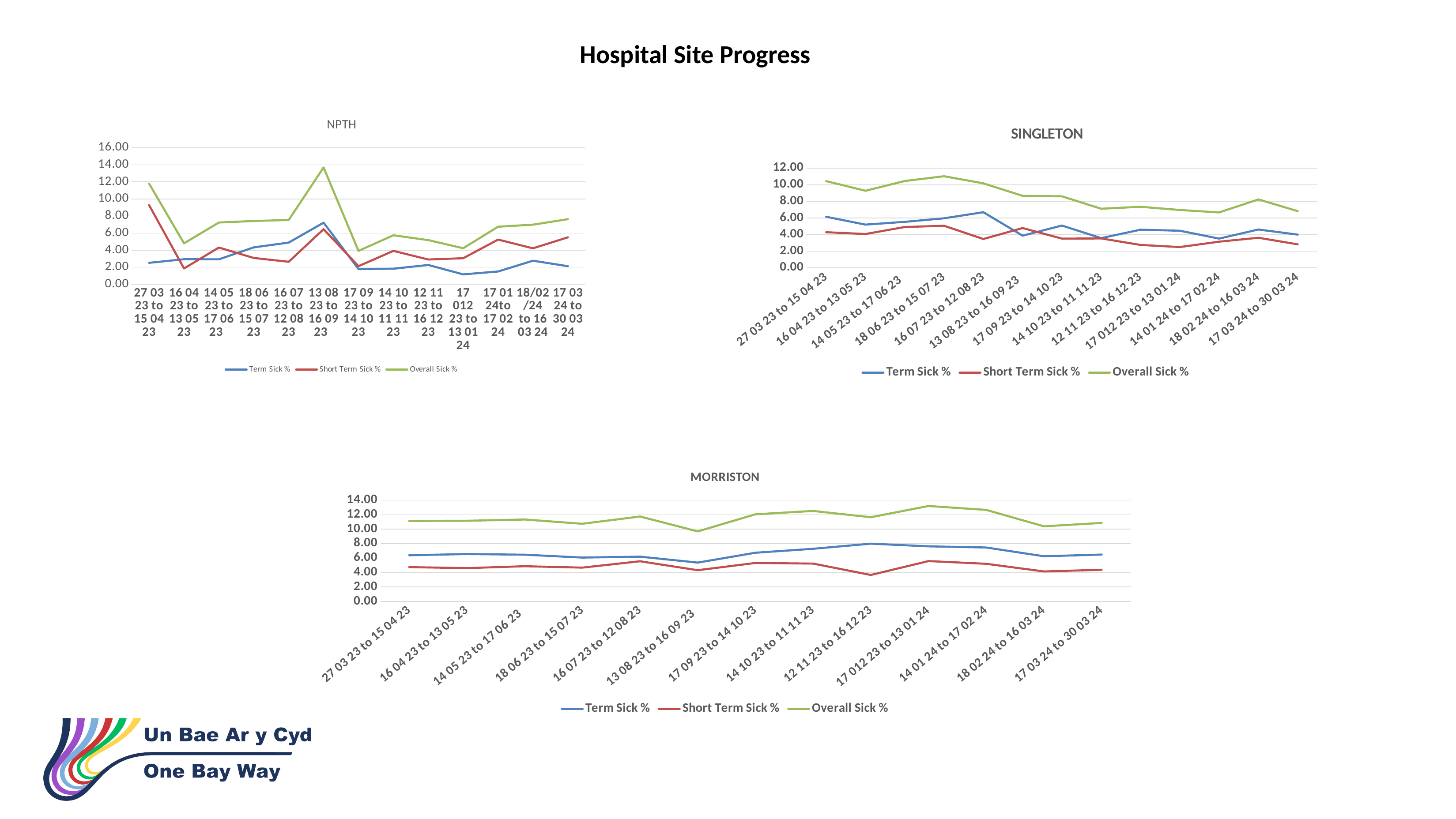
In the MORRISTON chart, which series is higher in 12 11 23 to 16 12 23: Term Sick % or Short Term Sick %? Term Sick % In the MORRISTON chart, in which period is Overall Sick % at its highest? 17 012 23 to 13 01 24 How many time periods are plotted on the x axis of the MORRISTON chart? 13 How many series does the legend of the SINGLETON chart list? 3 In the MORRISTON chart, in which period is Overall Sick % at its lowest? 13 08 23 to 16 09 23 In the SINGLETON chart, does Overall Sick % generally rise or fall from the first period to the last? fall In the NPTH chart, is the Overall Sick % value for 27 03 23 to 15 04 23 greater or less than 10.00? greater In the SINGLETON chart, is the Short Term Sick % value for 17 03 24 to 30 03 24 greater or less than 4.00? less In the SINGLETON chart, in which period is Overall Sick % highest? 18 06 23 to 15 07 23 In the NPTH chart, in which period does Overall Sick % reach its highest value? 13 08 23 to 16 09 23 What type of chart is the NPTH chart? line chart In the NPTH chart, in which period is Term Sick % at its lowest? 17 012 23 to 13 01 24